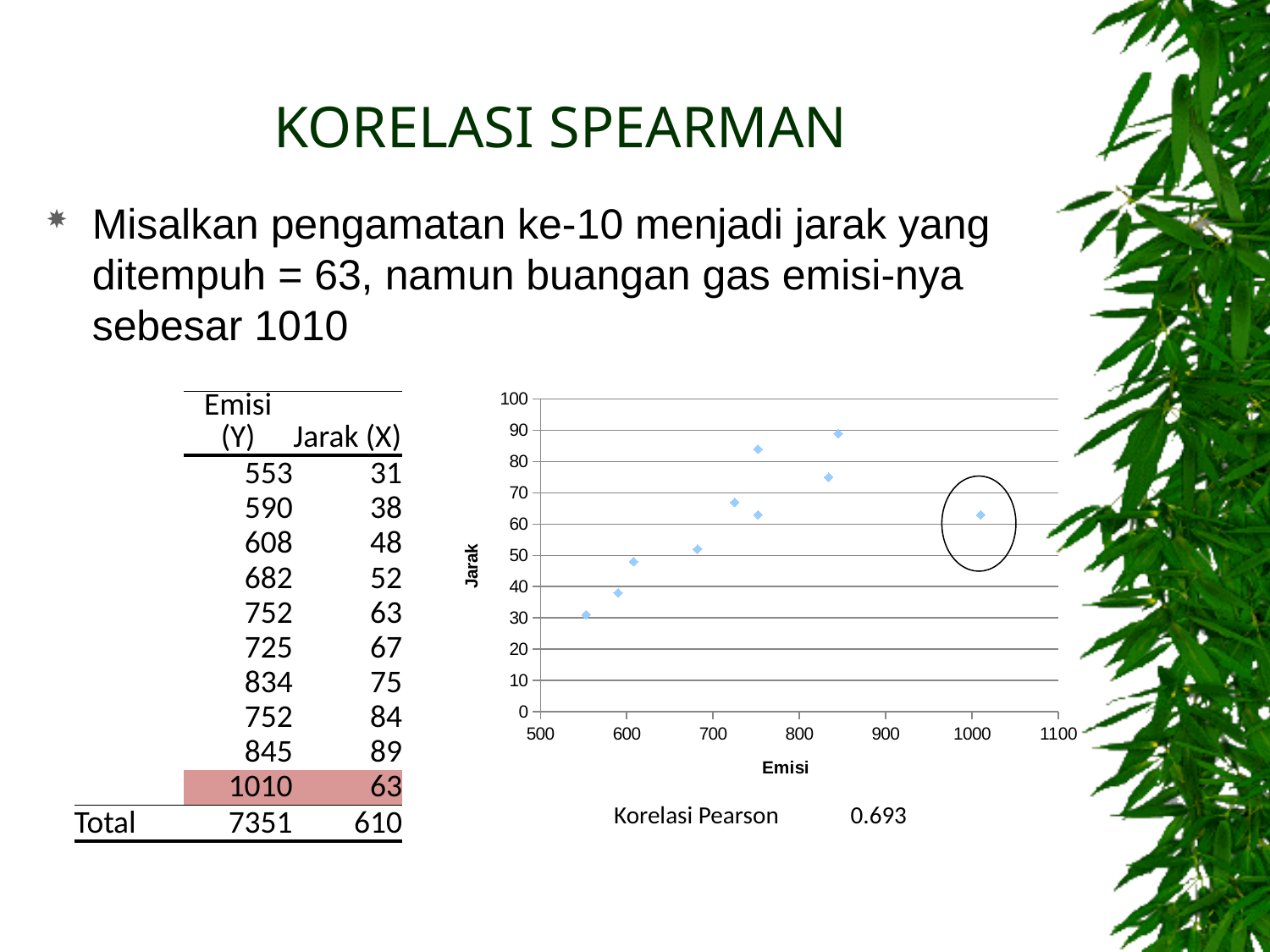
What is the label of the vertical axis of the chart? Jarak Is the Emisi value of the circled point greater or less than 1000? greater What is the label of the horizontal axis of the chart? Emisi What kind of chart is shown on the slide? Scatter chart What are the Emisi and Jarak values of the circled point in the chart? Emisi 1010, Jarak 63 What Korelasi Pearson value is printed below the chart? 0.693 Is the highest Jarak value plotted in the chart greater or less than 80? greater How many data points are plotted in the scatter chart? 10 Is the Jarak value of the point with the lowest Emisi greater or less than 40? less How many points in the chart have a Jarak value above 80? 2 How many points in the chart have an Emisi value above 900? 1